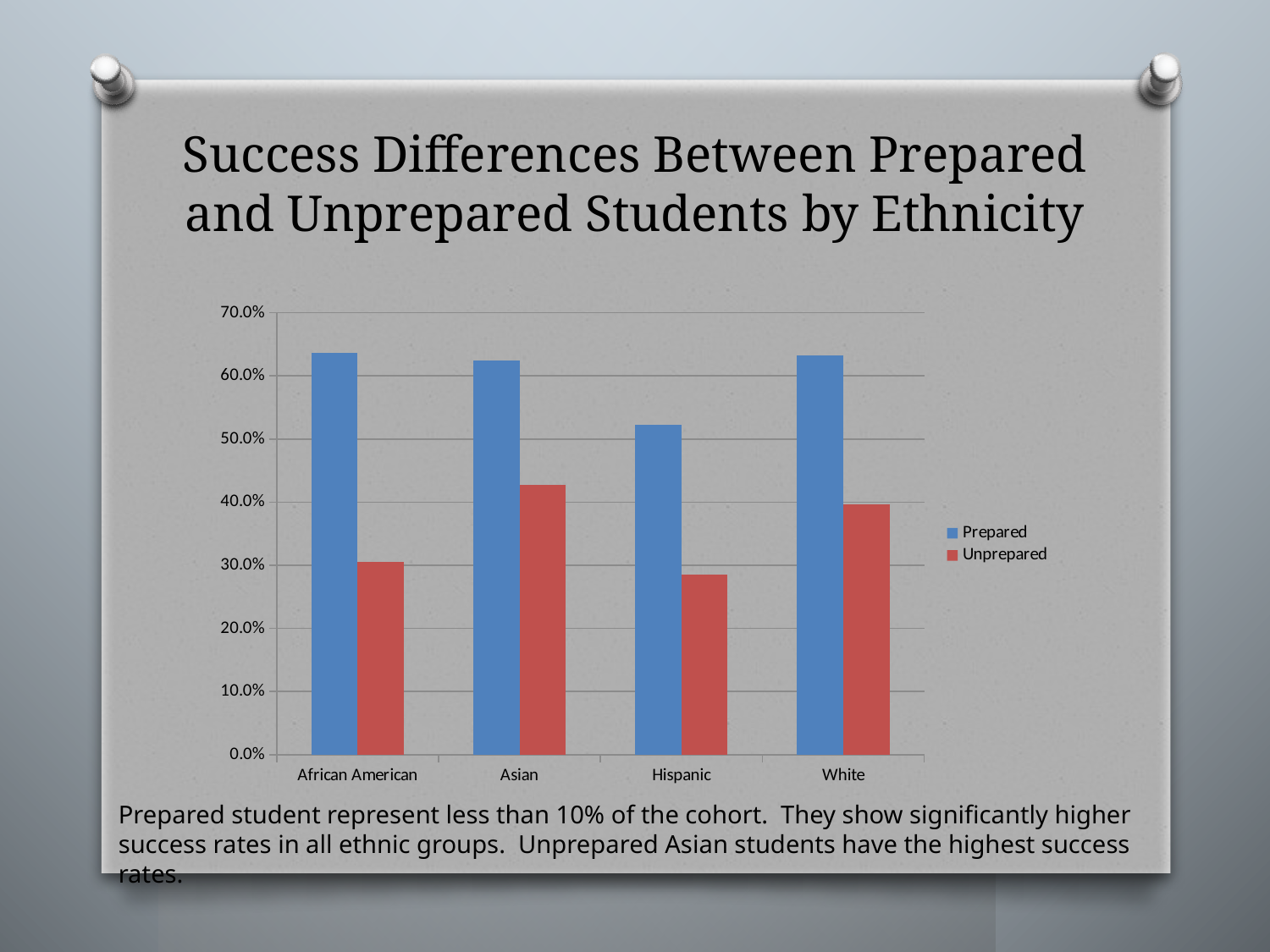
Which ethnic group has the highest Unprepared success rate? Asian What kind of chart is shown on the slide? bar chart How many ethnic groups are shown on the x axis of the chart? 4 Which is larger, the Unprepared value for Asian or the Unprepared value for White? Asian Which is larger, the Prepared value for White or the Prepared value for Hispanic? White Which ethnic group has the lowest Prepared success rate? Hispanic Is the Unprepared value for Hispanic greater or less than 30.0%? less Is the Prepared value for African American greater or less than 60.0%? greater How many series does the chart's legend list? 2 Is the Unprepared value for Asian greater or less than 40.0%? greater Which series is shown in red in the chart? Unprepared